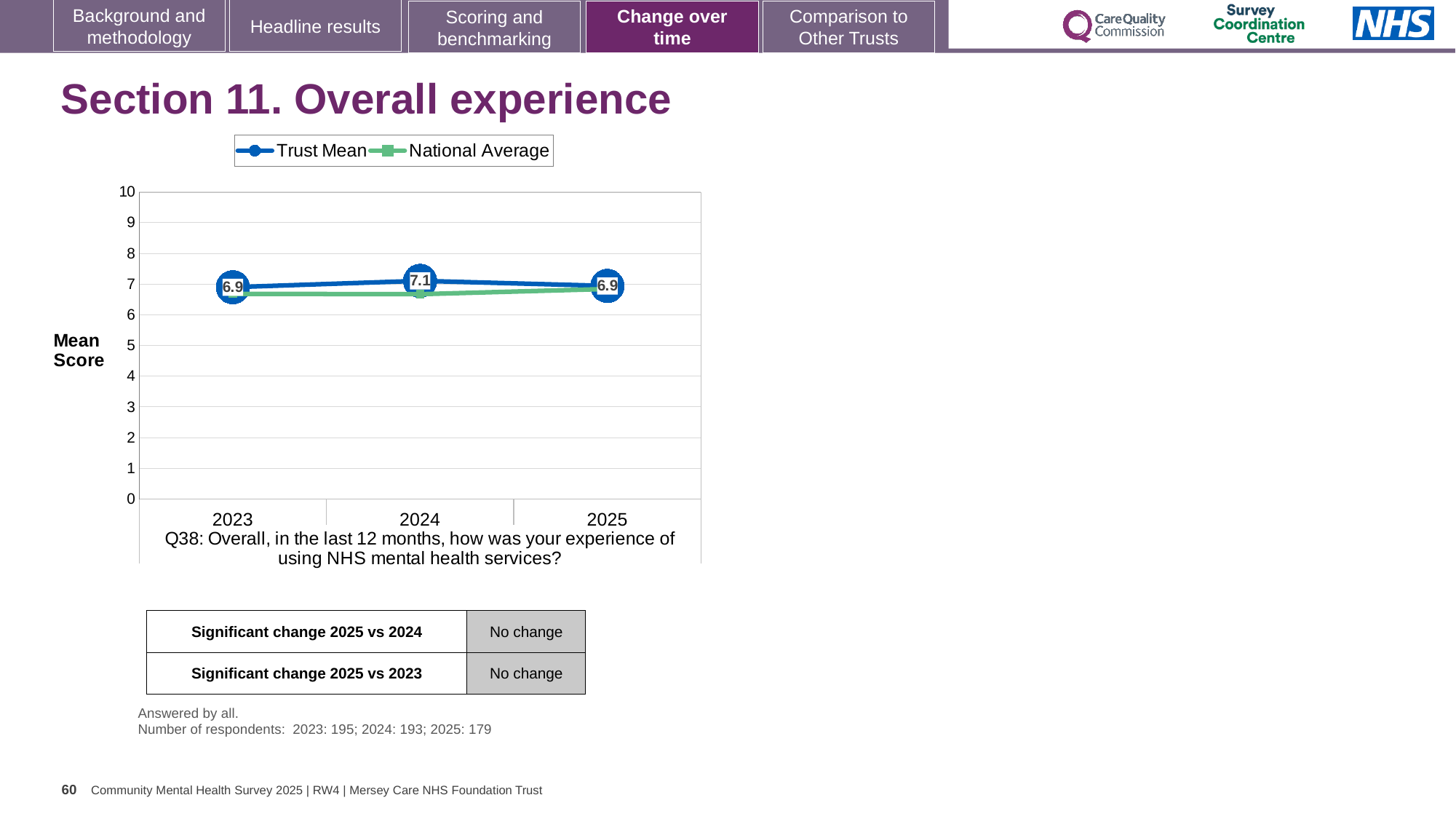
What is the label on the y axis of the chart? Mean Score What kind of chart is shown on the slide? line chart What is the difference between the Trust Mean in 2024 and in 2023? 0.2 In which year is the Trust Mean highest? 2024 How many years are plotted on the x axis? 3 How many series does the legend list? 2 Is the National Average value for 2023 greater or less than 7? less What is the Trust Mean value for 2023? 6.9 Which is larger, the Trust Mean for 2024 or for 2025? 2024 Does the Trust Mean rise or fall from 2024 to 2025? fall What is the Trust Mean value for 2025? 6.9 What is the Trust Mean value for 2024? 7.1